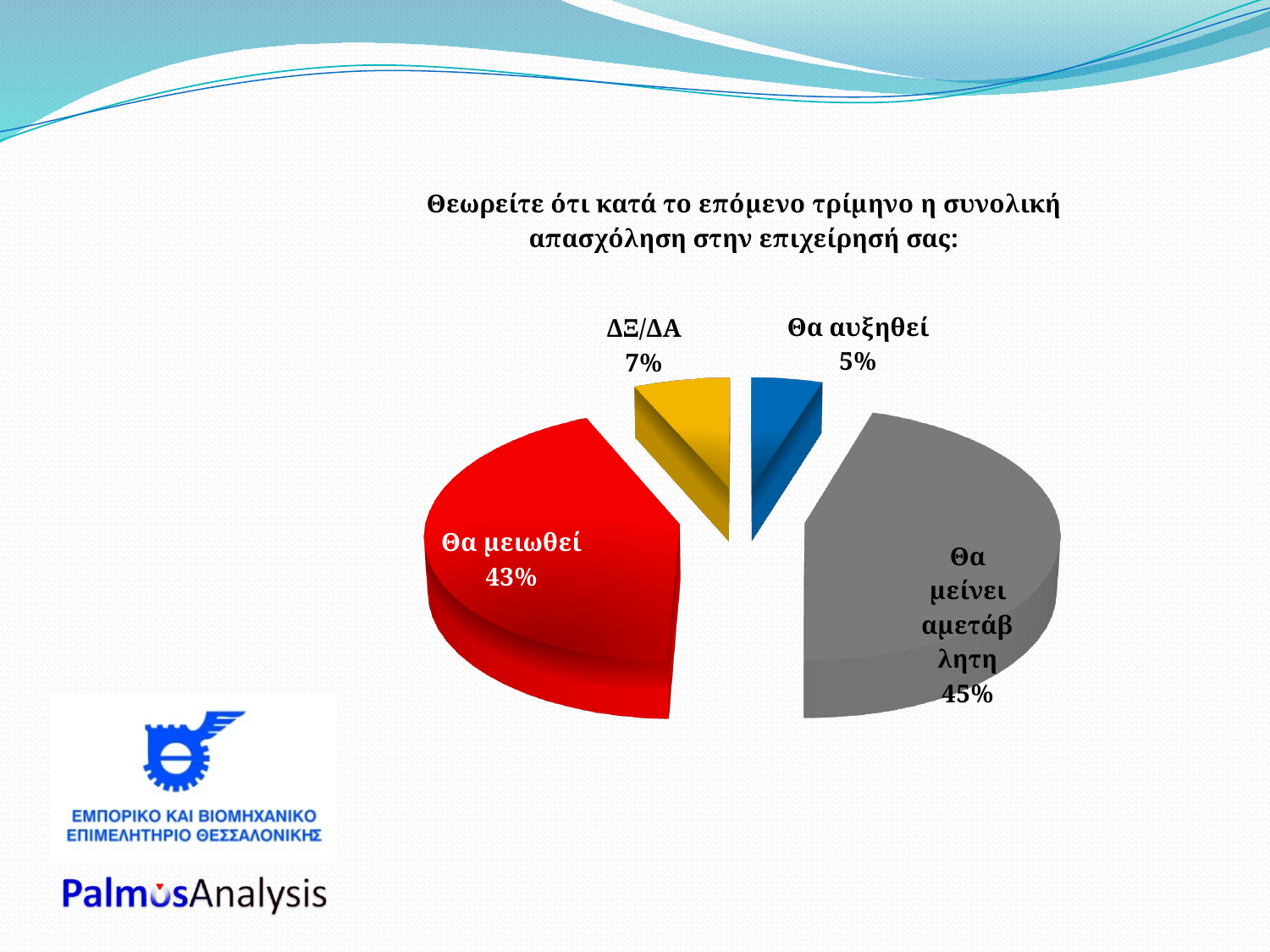
What is the difference in percentage points between "Θα μείνει αμετάβλητη" and "Θα μειωθεί"? 2 percentage points How many categories are shown in the pie chart? 4 What is the title of the chart? Θεωρείτε ότι κατά το επόμενο τρίμηνο η συνολική απασχόληση στην επιχείρησή σας: What is the value shown for "Θα αυξηθεί"? 5% What share of the pie does "Θα μειωθεί" represent? 43% Which category has the largest slice of the pie? Θα μείνει αμετάβλητη Which is larger, the share for "ΔΞ/ΔΑ" or the share for "Θα αυξηθεί"? ΔΞ/ΔΑ What is the value shown for "ΔΞ/ΔΑ"? 7% What share of the pie does "Θα μείνει αμετάβλητη" represent? 45% Which category has the smallest slice of the pie? Θα αυξηθεί What colour is the slice for "Θα μειωθεί"? Red What kind of chart is shown on the slide? Pie chart